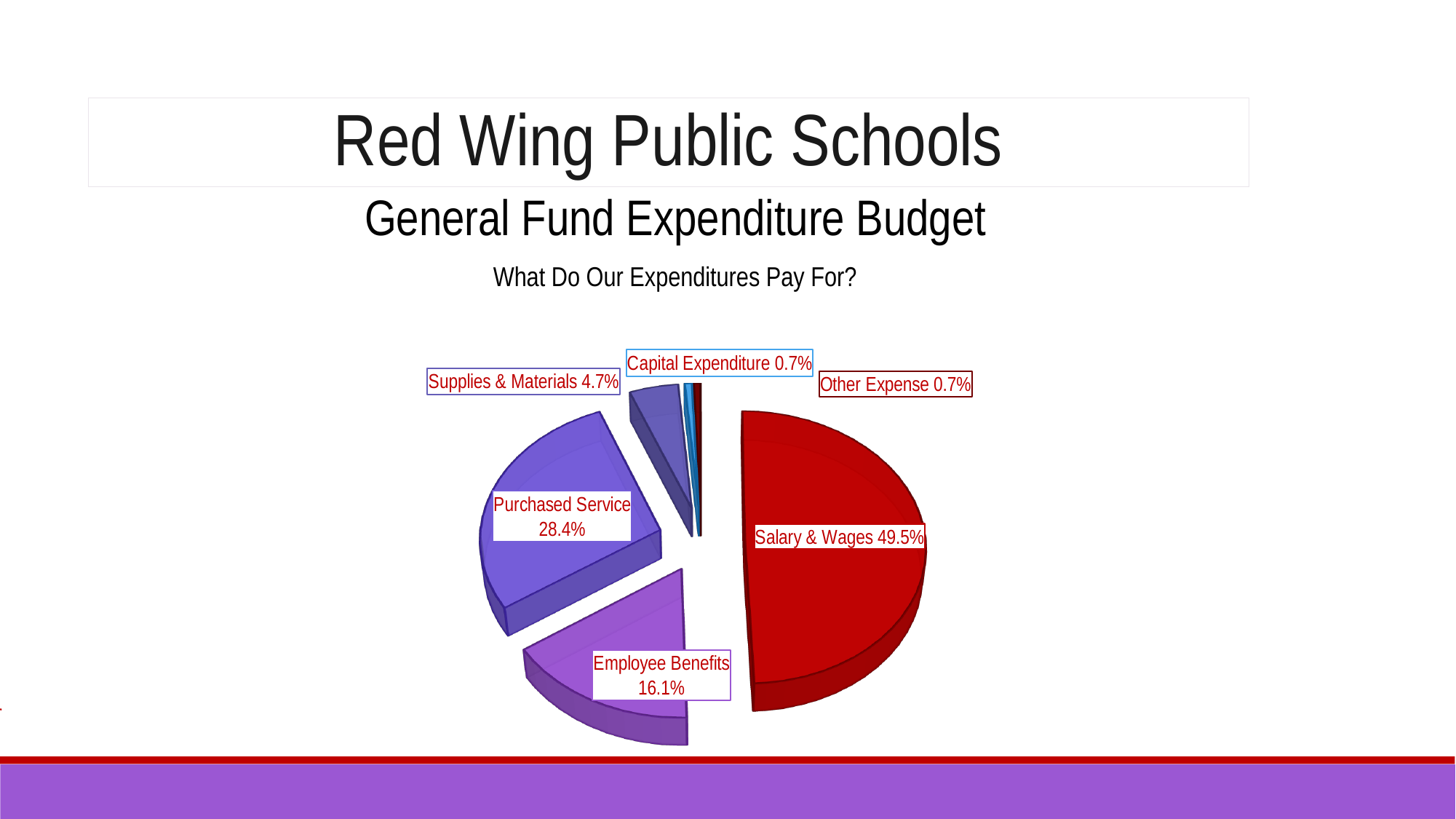
What share of the General Fund Expenditure Budget goes to Salary & Wages? 49.5% What percentage is shown for Purchased Service? 28.4% What percentage is shown for Capital Expenditure? 0.7% Which is larger, Purchased Service or Employee Benefits? Purchased Service Which category has the largest share of the expenditure budget? Salary & Wages What is the combined share of Salary & Wages and Employee Benefits? 65.6% How many categories are shown in the pie chart? 6 What kind of chart is shown on the slide? Pie chart What colour is the Salary & Wages slice? Red What percentage is shown for Supplies & Materials? 4.7% What percentage is shown for Employee Benefits? 16.1% How many percentage points larger is Salary & Wages than Purchased Service? 21.1 percentage points